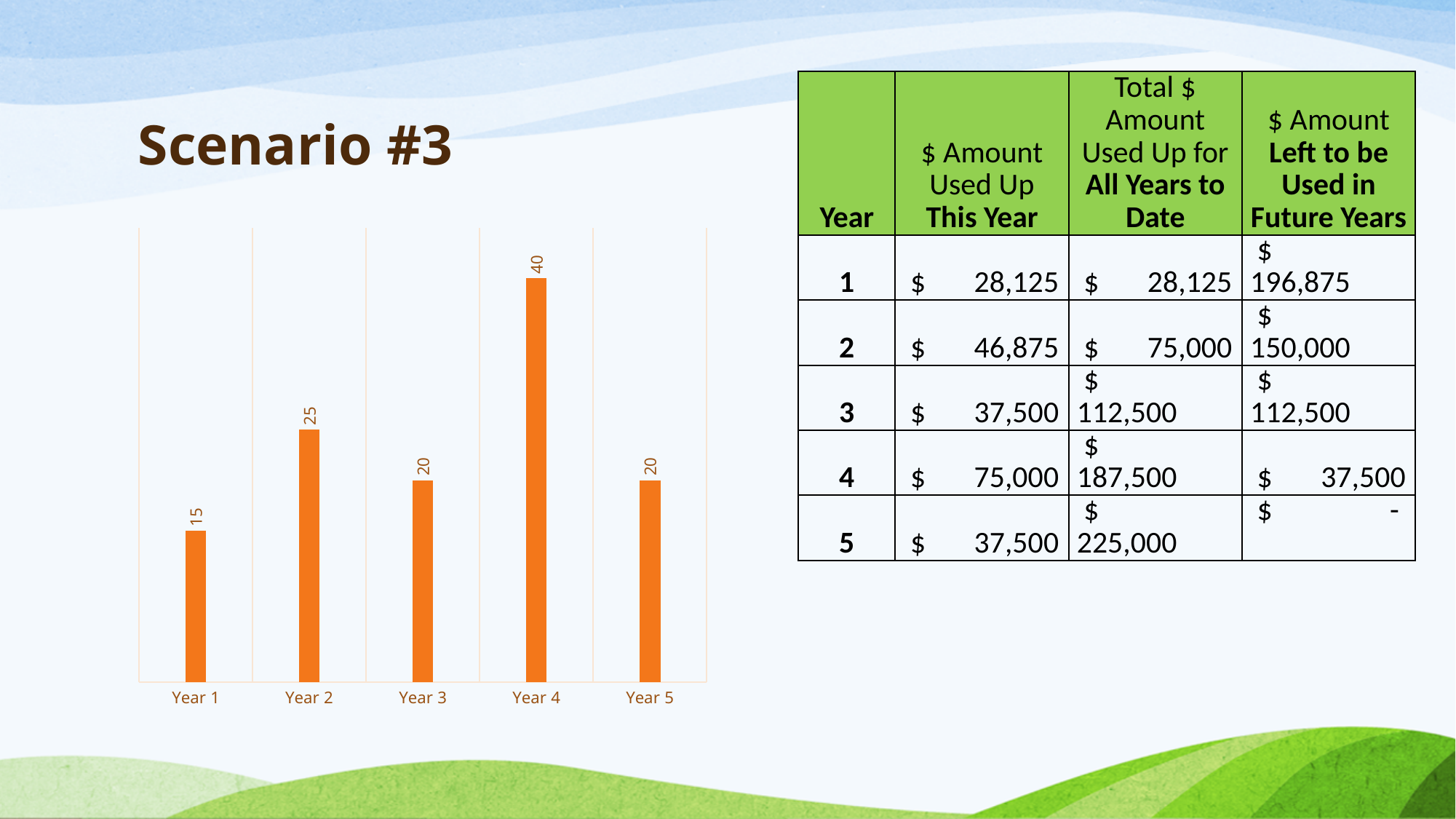
What is the difference between the values for Year 2 and Year 1? 10 What is the difference between the values for Year 4 and Year 2? 15 What colour are the bars in the chart? Orange What is the value for Year 2 in the bar chart? 25 Which is larger, the value for Year 2 or the value for Year 3? Year 2 Which year has the highest bar in the chart? Year 4 What is the value for Year 4 in the bar chart? 40 Do the values for Year 3 and Year 5 in the chart match? Yes, both are 20 How many bars are shown in the chart? 5 What is the value for Year 1 in the bar chart? 15 What kind of chart is shown on the slide? Bar chart Which year has the lowest bar in the chart? Year 1